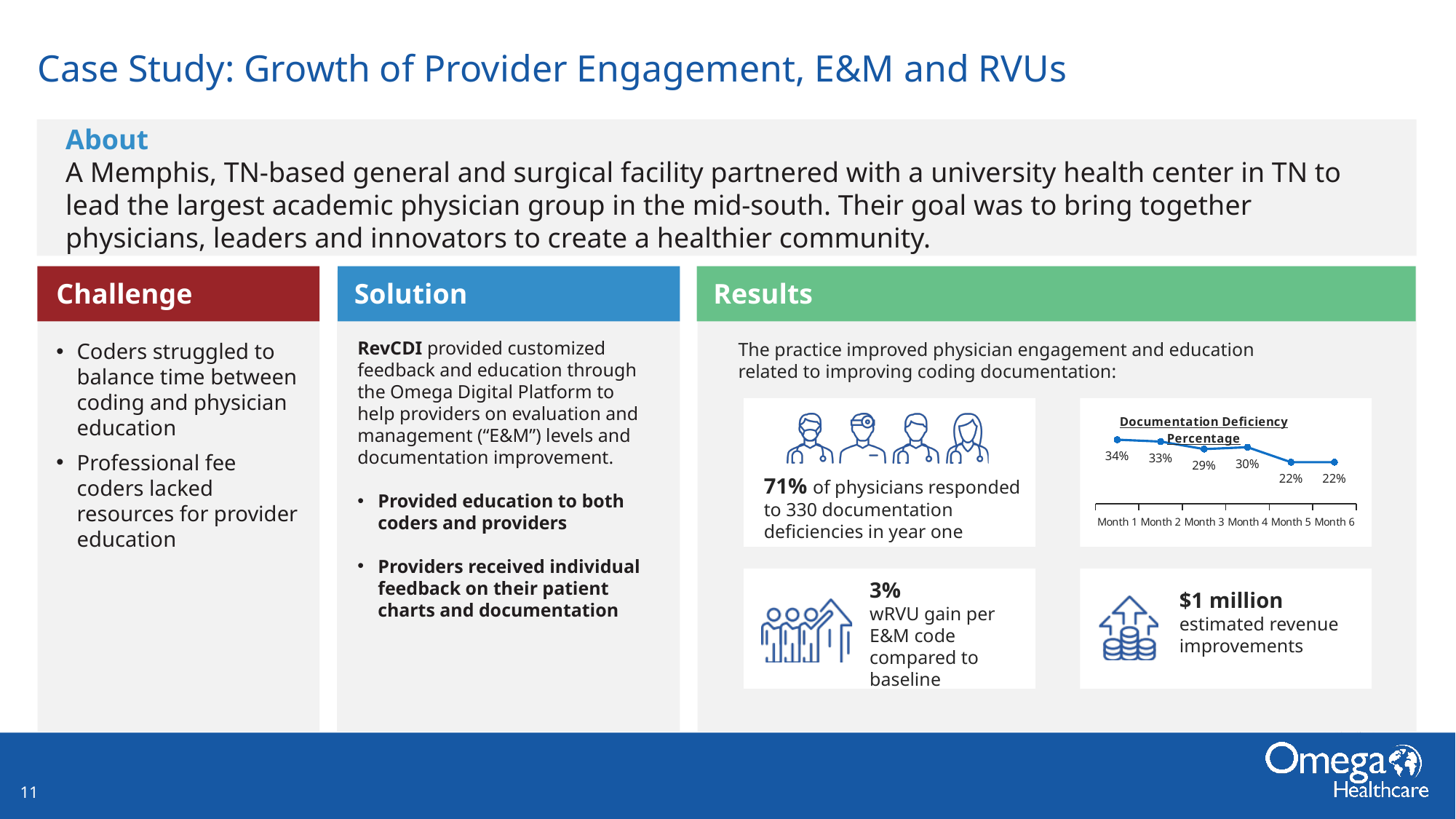
Which is larger, the Documentation Deficiency Percentage in Month 4 or Month 5? Month 4 What is the difference between the Documentation Deficiency Percentage in Month 2 and Month 3? 4% What is the difference between the Documentation Deficiency Percentage in Month 1 and Month 6? 12% How many months are plotted in the Documentation Deficiency Percentage chart? 6 What is the title of the line chart in the Results section? Documentation Deficiency Percentage Which month has the highest Documentation Deficiency Percentage? Month 1 What is the Documentation Deficiency Percentage for Month 1? 34% What is the Documentation Deficiency Percentage for Month 3? 29% What is the Documentation Deficiency Percentage for Month 4? 30% What kind of chart is the Documentation Deficiency Percentage chart? Line chart What is the Documentation Deficiency Percentage for Month 6? 22% Does the Documentation Deficiency Percentage rise or fall from Month 1 to Month 6? Fall